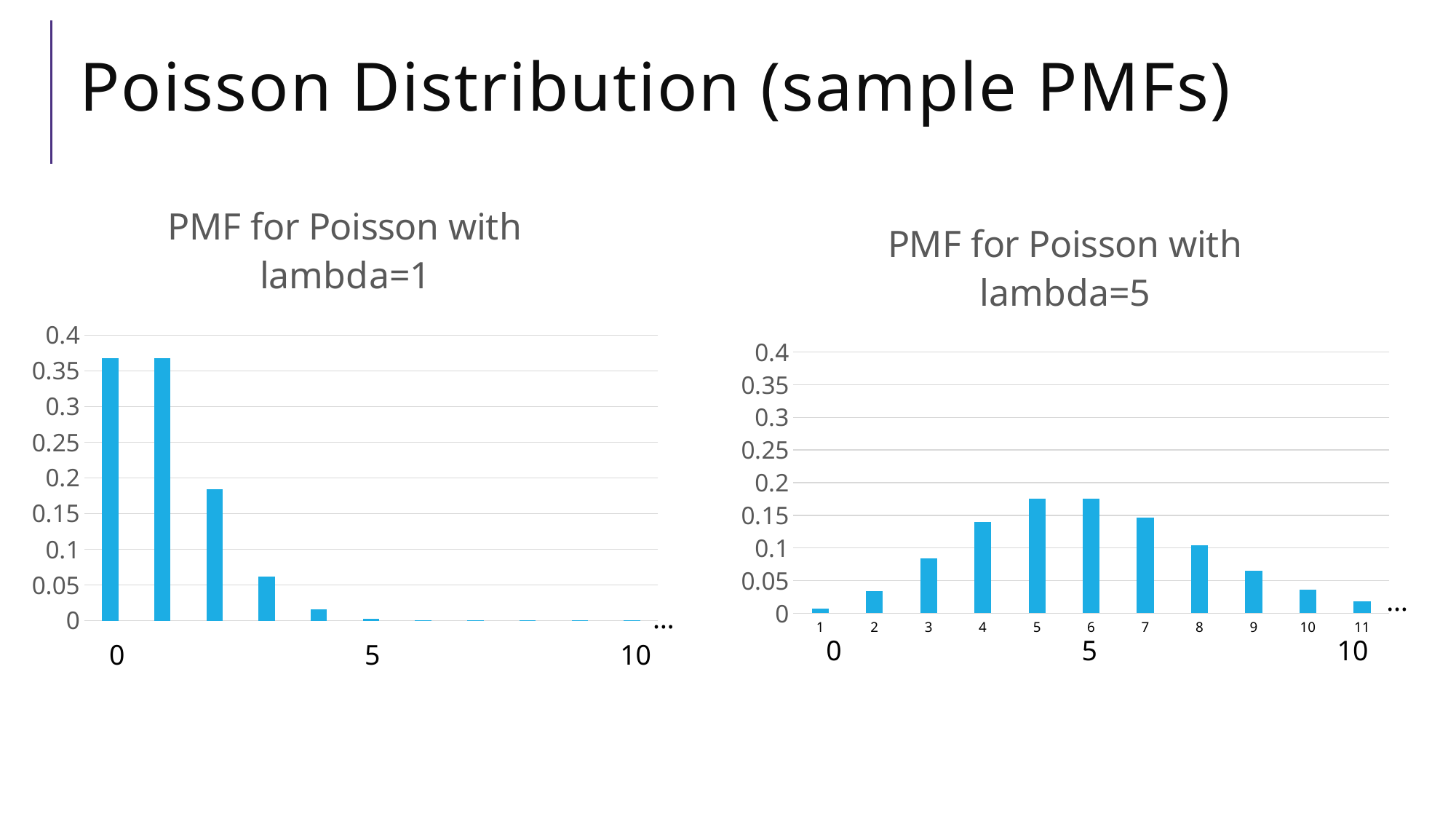
In the 'PMF for Poisson with lambda=1' chart, is the value at x=0 greater or less than 0.3? greater In the 'PMF for Poisson with lambda=1' chart, is the value at x=3 greater or less than 0.1? less In the 'PMF for Poisson with lambda=5' chart, is the value for bar 5 greater or less than 0.15? greater In the 'PMF for Poisson with lambda=1' chart, which is larger, the value at x=2 or the value at x=3? x=2 What is the title of the chart on the right side of the slide? PMF for Poisson with lambda=5 What kind of chart is the 'PMF for Poisson with lambda=1' chart? bar chart In the 'PMF for Poisson with lambda=5' chart, which is larger, the value for bar 4 or the value for bar 9? bar 4 How many bars are labelled on the x axis of the 'PMF for Poisson with lambda=5' chart? 11 In the 'PMF for Poisson with lambda=5' chart, which labelled bar has the lowest value? 1 In the 'PMF for Poisson with lambda=1' chart, do the values rise or fall as x increases? fall